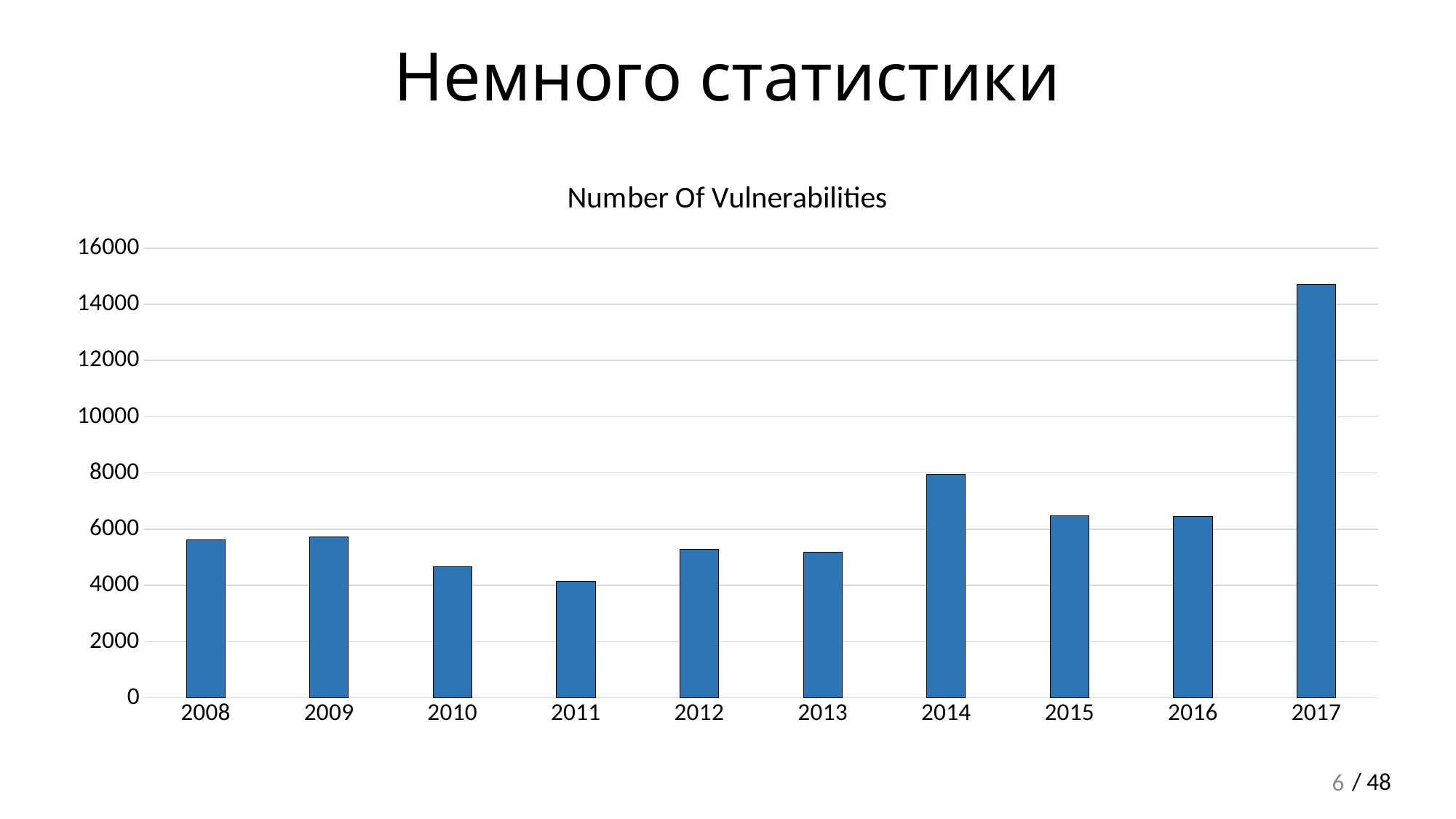
Do the values rise or fall from 2009 to 2011? fall Is the value for 2014 greater or less than 6000? greater What is the title of the chart? Number Of Vulnerabilities Is the value for 2017 greater or less than 14000? greater Which year has a larger value, 2011 or 2008? 2008 What type of chart is shown on the slide? bar chart Is the value for 2011 greater or less than 6000? less How many years are shown on the x axis of the chart? 10 Which year has a larger value, 2014 or 2015? 2014 Which year has the highest number of vulnerabilities? 2017 Which year has the lowest number of vulnerabilities? 2011